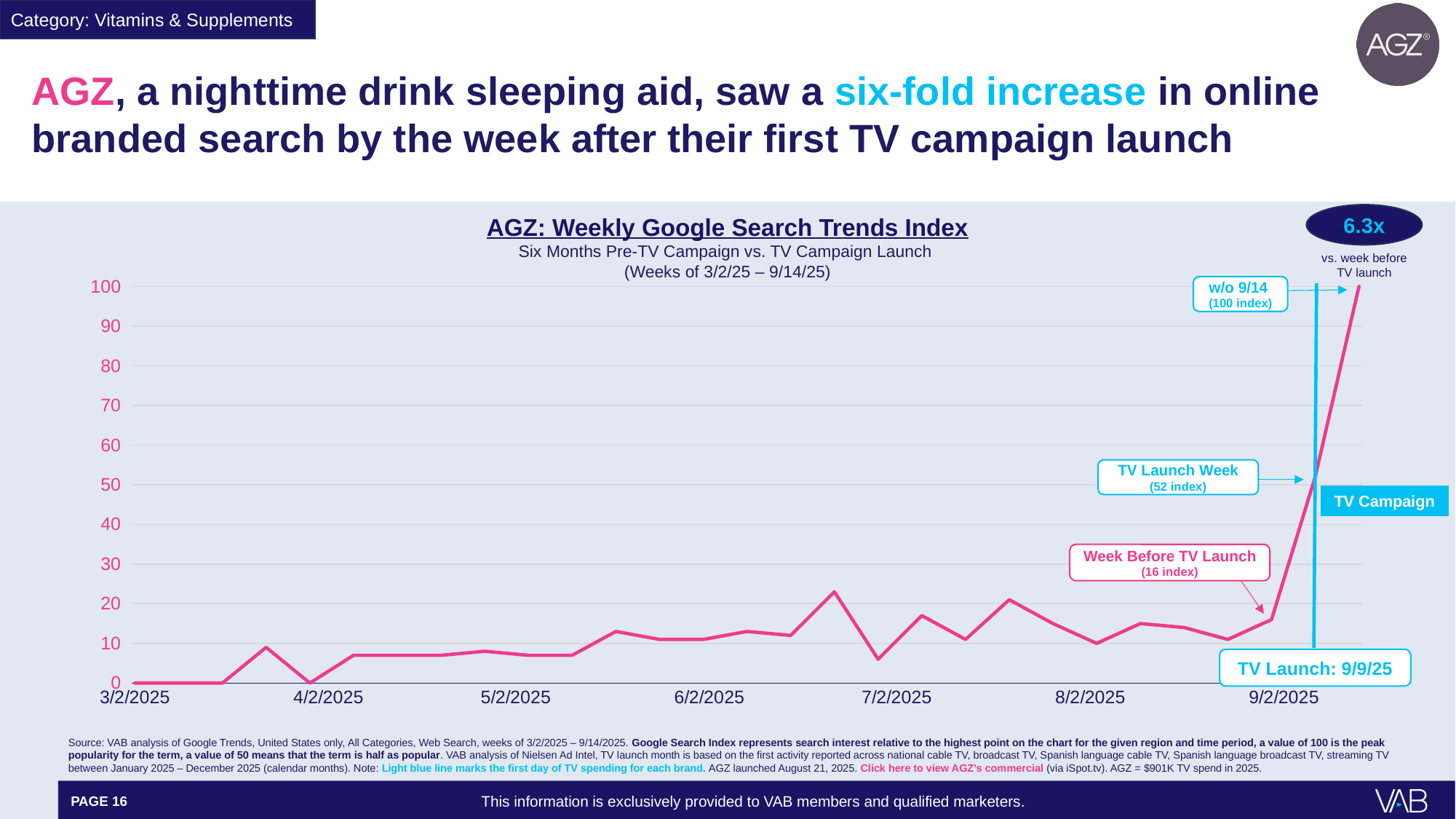
What kind of chart is shown on the slide? line chart What is the title of the chart? AGZ: Weekly Google Search Trends Index What TV launch date is marked on the chart? 9/9/25 What is the search index value for the Week Before TV Launch? 16 What is the search index value for the week of 9/14 (w/o 9/14)? 100 What is the difference between the index for the week of 9/14 and the Week Before TV Launch? 84 What is the search index value for the TV Launch Week? 52 What is the difference between the TV Launch Week index and the Week Before TV Launch index? 36 Which week has the highest search index value on the chart? w/o 9/14 Which is larger, the index for the TV Launch Week or the index for the Week Before TV Launch? TV Launch Week Does the search index generally rise or fall from 3/2/2025 to the week of 9/14/2025? rise